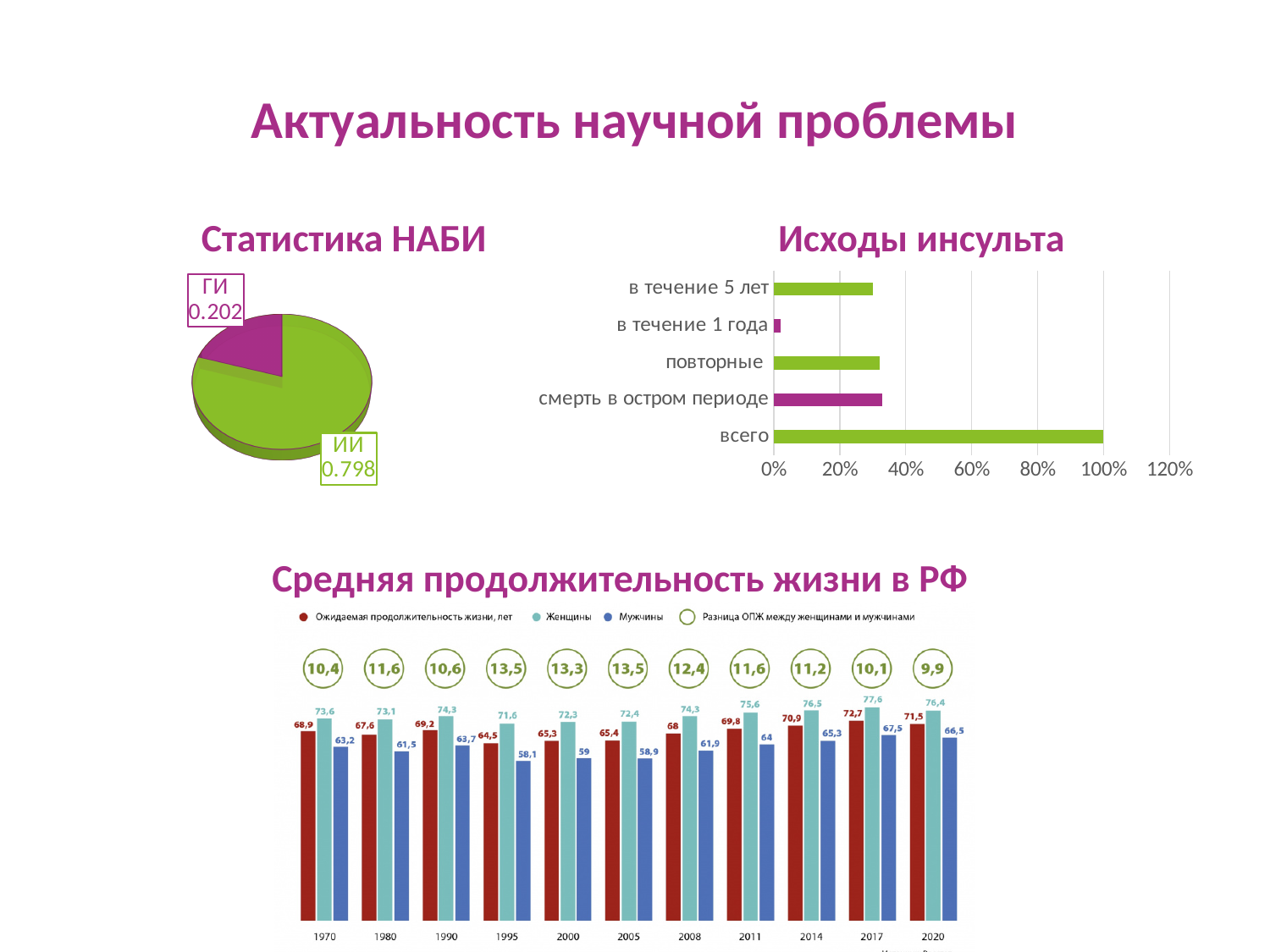
On the 'Исходы инсульта' chart, is the value for 'в течение 5 лет' greater or less than 40%? less On the 'Средняя продолжительность жизни в РФ' chart, how many years are shown on the x axis? 11 On the 'Средняя продолжительность жизни в РФ' chart, what is the value for Женщины in 2020? 76,4 On the 'Исходы инсульта' chart, is the value for 'смерть в остром периоде' greater or less than 20%? greater On the 'Статистика НАБИ' pie chart, what is the value shown for ГИ? 0.202 On the 'Средняя продолжительность жизни в РФ' chart, what is the value for Мужчины in 1970? 63,2 On the 'Исходы инсульта' chart, which category has the lowest value? в течение 1 года On the 'Статистика НАБИ' pie chart, which slice is larger, ГИ or ИИ? ИИ What kind of chart is 'Статистика НАБИ'? pie chart On the 'Исходы инсульта' chart, which category has the highest value? всего On the 'Исходы инсульта' chart, how many categories are shown? 5 On the 'Средняя продолжительность жизни в РФ' chart, what is the difference between the Женщины and Мужчины values in 2017? 10,1